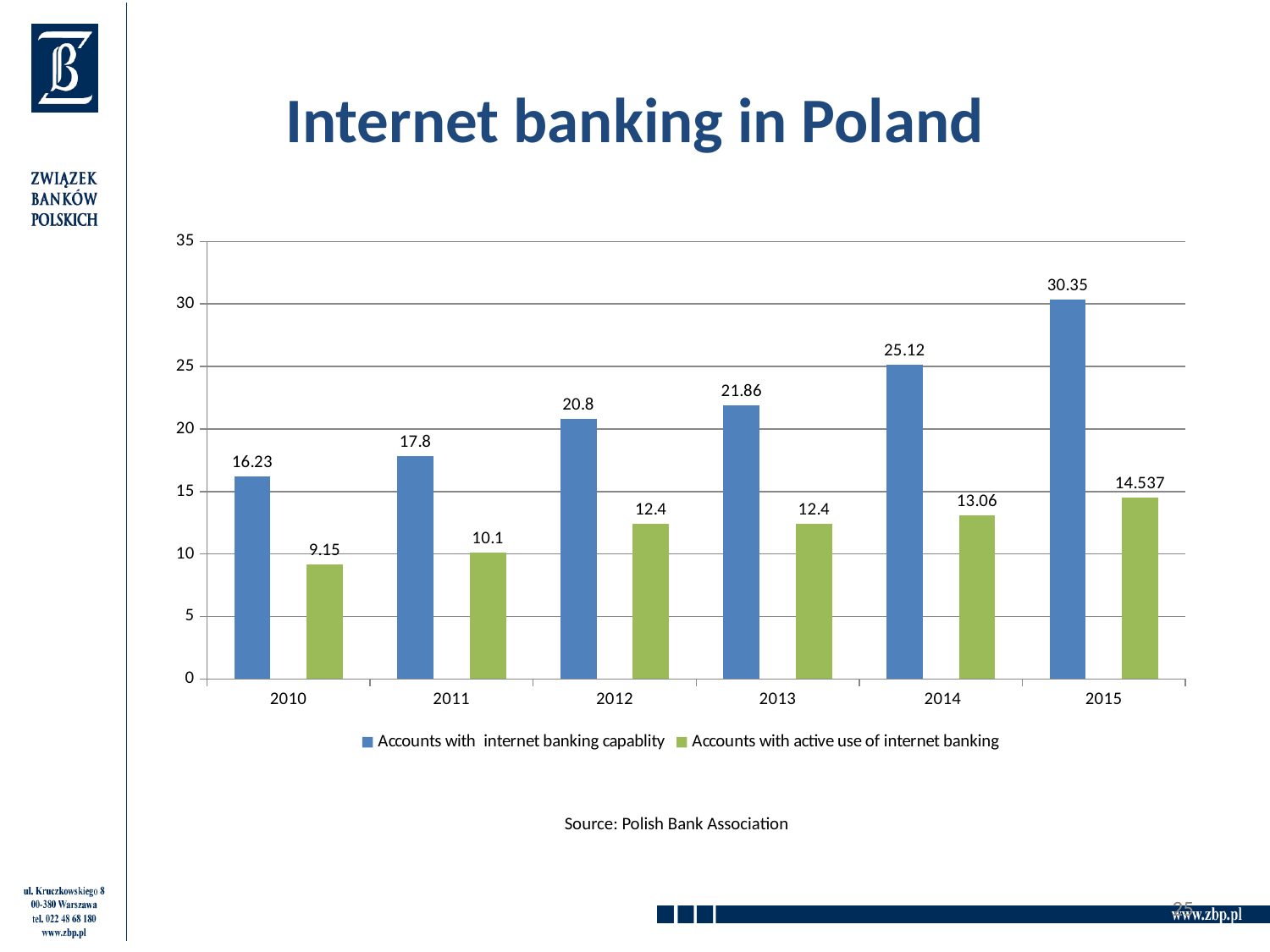
Is the value for Accounts with internet banking capablity in 2013 greater or less than 20? greater What kind of chart is shown on the slide? Bar chart Which year has the highest value for Accounts with internet banking capablity? 2015 What is the value for Accounts with active use of internet banking in 2010? 9.15 How many years are shown on the x axis? 6 What is the difference between Accounts with internet banking capablity and Accounts with active use of internet banking in 2014? 12.06 Do the values for Accounts with internet banking capablity rise or fall from 2010 to 2015? Rise Which is larger in 2012: Accounts with internet banking capablity or Accounts with active use of internet banking? Accounts with internet banking capablity What is the value for Accounts with active use of internet banking in 2015? 14.537 What is the value for Accounts with internet banking capablity in 2015? 30.35 How many series does the legend list? 2 Which year has the lowest value for Accounts with active use of internet banking? 2010